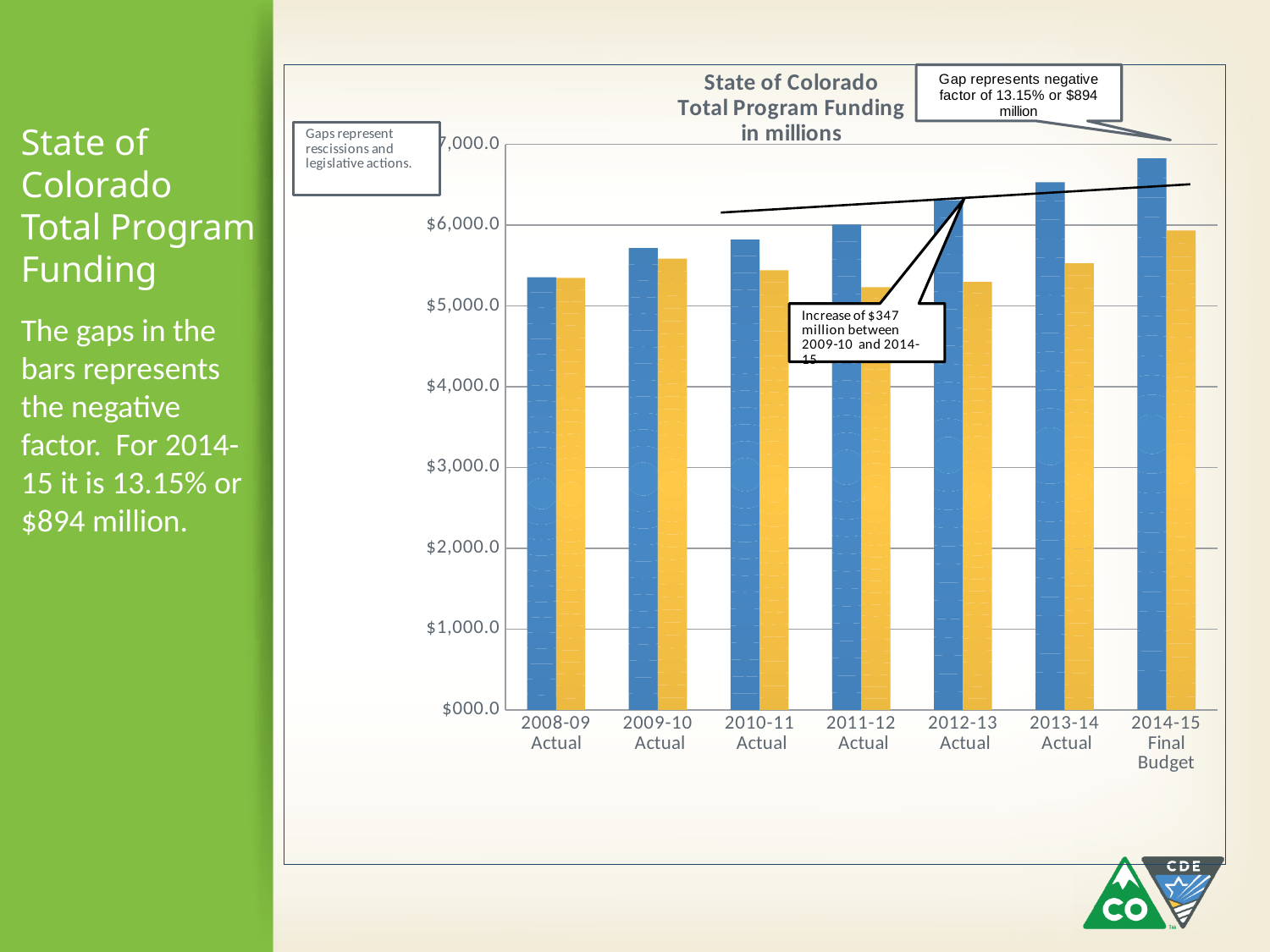
According to the annotation on the chart, what negative factor does the gap represent for 2014-15? 13.15% or $894 million Do the blue bars rise or fall from 2008-09 Actual to 2014-15 Final Budget? rise How many fiscal-year categories are shown on the x axis of the chart? 7 Is the yellow bar for 2014-15 Final Budget greater or less than $6,000.0? less Which fiscal year has the shortest blue bar? 2008-09 Actual What is the title of the chart? State of Colorado Total Program Funding in millions What kind of chart is shown on the slide? bar chart How many bars are plotted for each fiscal year in the chart? 2 Is the yellow bar for 2011-12 Actual greater or less than $5,000.0? greater Which fiscal year has the tallest blue bar? 2014-15 Final Budget In 2014-15 Final Budget, which bar is taller, the blue bar or the yellow bar? the blue bar Is the blue bar for 2014-15 Final Budget greater or less than $6,000.0? greater